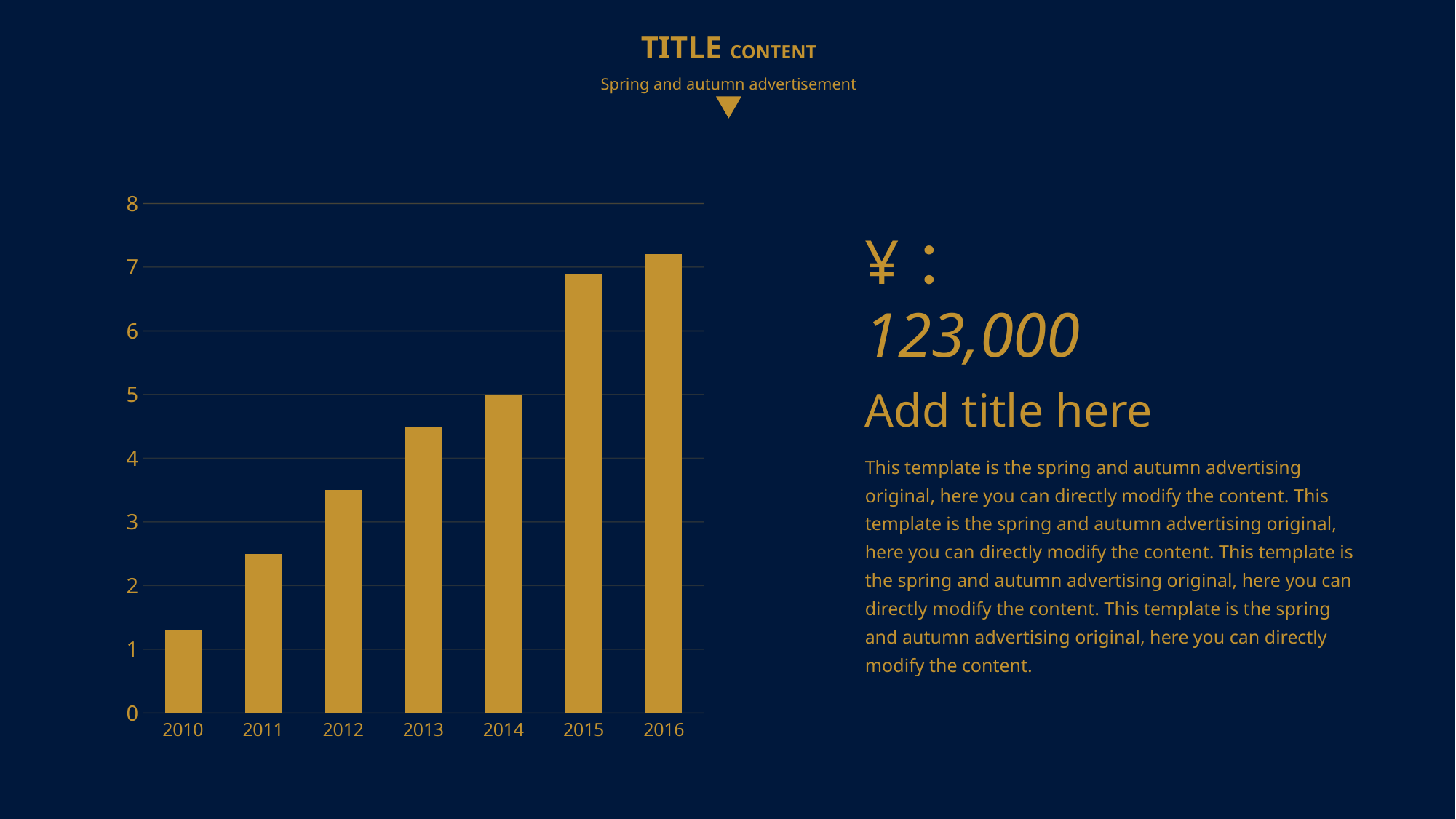
Which is larger, the value for 2013 or the value for 2015? 2015 Is the value for 2010 greater or less than 2? less Which year has the lowest bar in the chart? 2010 What is the highest value shown on the chart's vertical axis? 8 Is the value for 2013 greater or less than 4? greater How many years are shown on the x axis of the chart? 7 What is the value for 2014 in the chart? 5 What kind of chart is shown on the slide? bar chart Is the value for 2015 greater or less than 6? greater Do the values in the chart rise or fall from 2010 to 2016? rise Which year has the highest bar in the chart? 2016